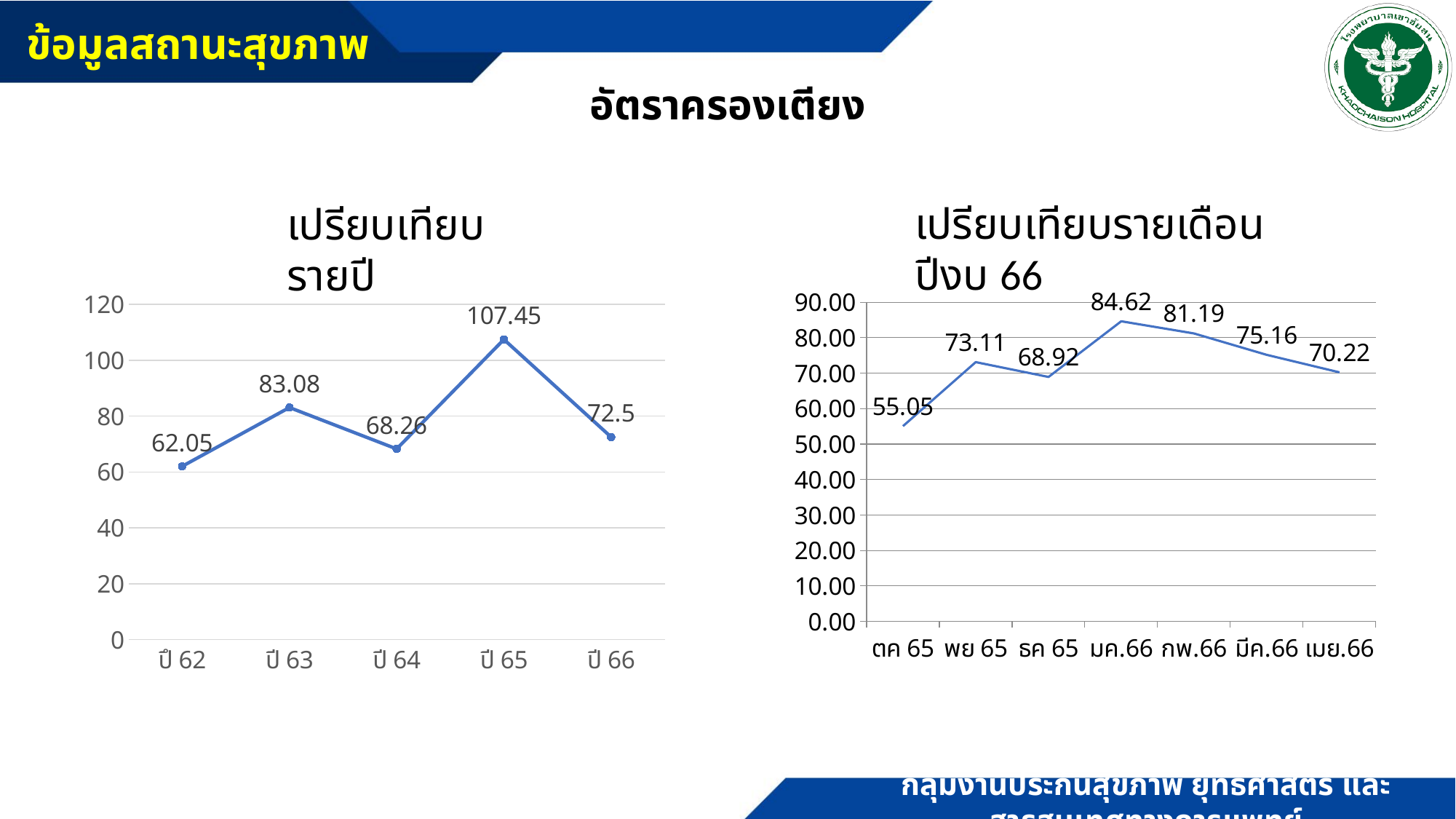
In the left chart (เปรียบเทียบรายปี), what is the value for ปี 65? 107.45 In the left chart (เปรียบเทียบรายปี), how many years are plotted? 5 In the right chart (เปรียบเทียบรายเดือน ปีงบ 66), do the values rise or fall from มค.66 to เมย.66? Fall In the right chart (เปรียบเทียบรายเดือน ปีงบ 66), how many months are plotted? 7 In the right chart (เปรียบเทียบรายเดือน ปีงบ 66), what is the value for ตค 65? 55.05 In the left chart (เปรียบเทียบรายปี), which year has the lowest value? ปี 62 What kind of chart is the left chart (เปรียบเทียบรายปี)? Line chart In the right chart (เปรียบเทียบรายเดือน ปีงบ 66), which is larger, the value for พย 65 or ธค 65? พย 65 In the right chart (เปรียบเทียบรายเดือน ปีงบ 66), what is the value for มค.66? 84.62 In the left chart (เปรียบเทียบรายปี), what is the difference between the values for ปี 63 and ปี 64? 14.82 In the right chart (เปรียบเทียบรายเดือน ปีงบ 66), which month has the highest value? มค.66 In the left chart (เปรียบเทียบรายปี), what is the value for ปี 62? 62.05